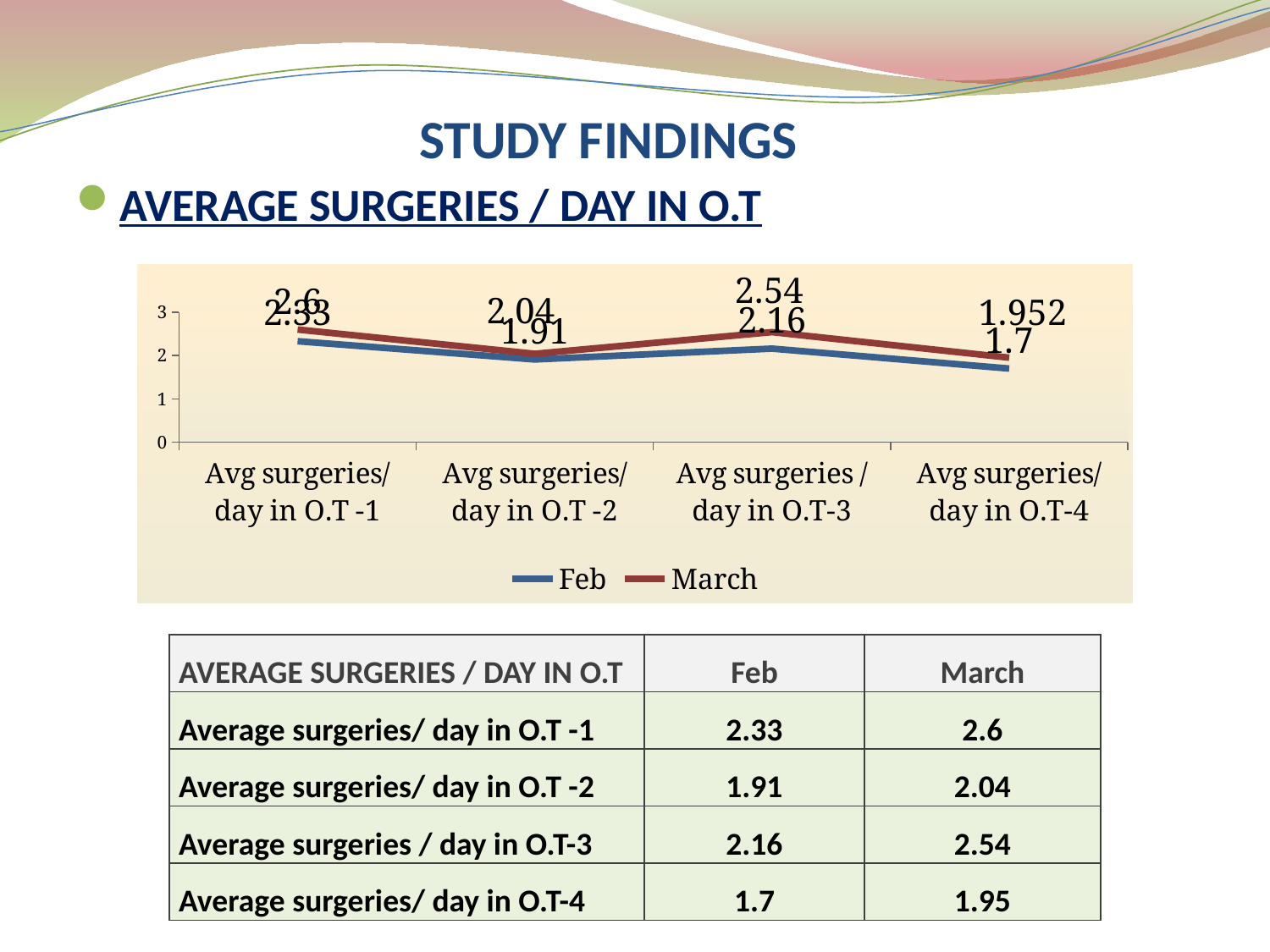
Which is larger for Avg surgeries/ day in O.T -1, the Feb value or the March value? March How many categories are plotted along the x axis of the chart? 4 Which category has the lowest March value? Avg surgeries/ day in O.T-4 What is the Feb value for Avg surgeries/ day in O.T-4? 1.7 Which category has the highest Feb value? Avg surgeries/ day in O.T -1 What is the March value for Avg surgeries / day in O.T-3? 2.54 How many series does the chart legend list? 2 What is the March value for Avg surgeries/ day in O.T -2? 2.04 What is the difference between the March and Feb values for Avg surgeries / day in O.T-3? 0.38 What kind of chart is shown on the slide? line chart Which series is drawn in blue in the chart? Feb What is the Feb value for Avg surgeries/ day in O.T -1? 2.33